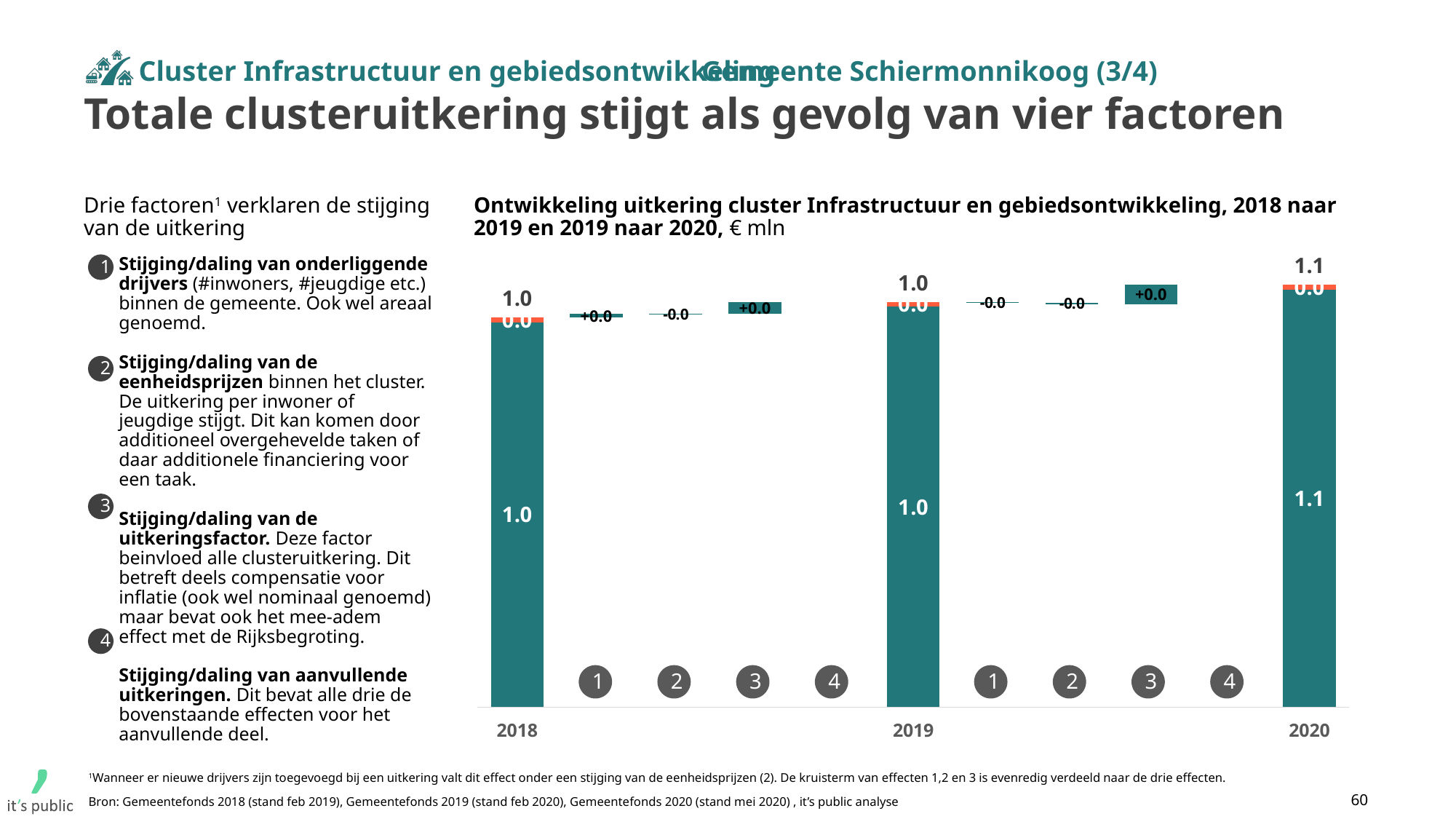
Which year has the highest total cluster payment? 2020 What is the total cluster payment shown for 2019? 1.0 What is the total cluster payment shown for 2020? 1.1 What is the labelled effect of factor 2 between 2018 and 2019? -0.0 Which is larger, the total for 2020 or the total for 2018? 2020 What kind of chart is shown on the slide? Bar chart (waterfall) How many year totals (2018, 2019, 2020) are shown in the chart? 3 In what unit are the values in the chart expressed? € mln What is the difference between the 2020 total and the 2018 total? 0.1 What is the labelled effect of factor 3 between 2018 and 2019? +0.0 What is the total cluster payment shown for 2018? 1.0 Do the year totals rise or fall from 2018 to 2020? Rise